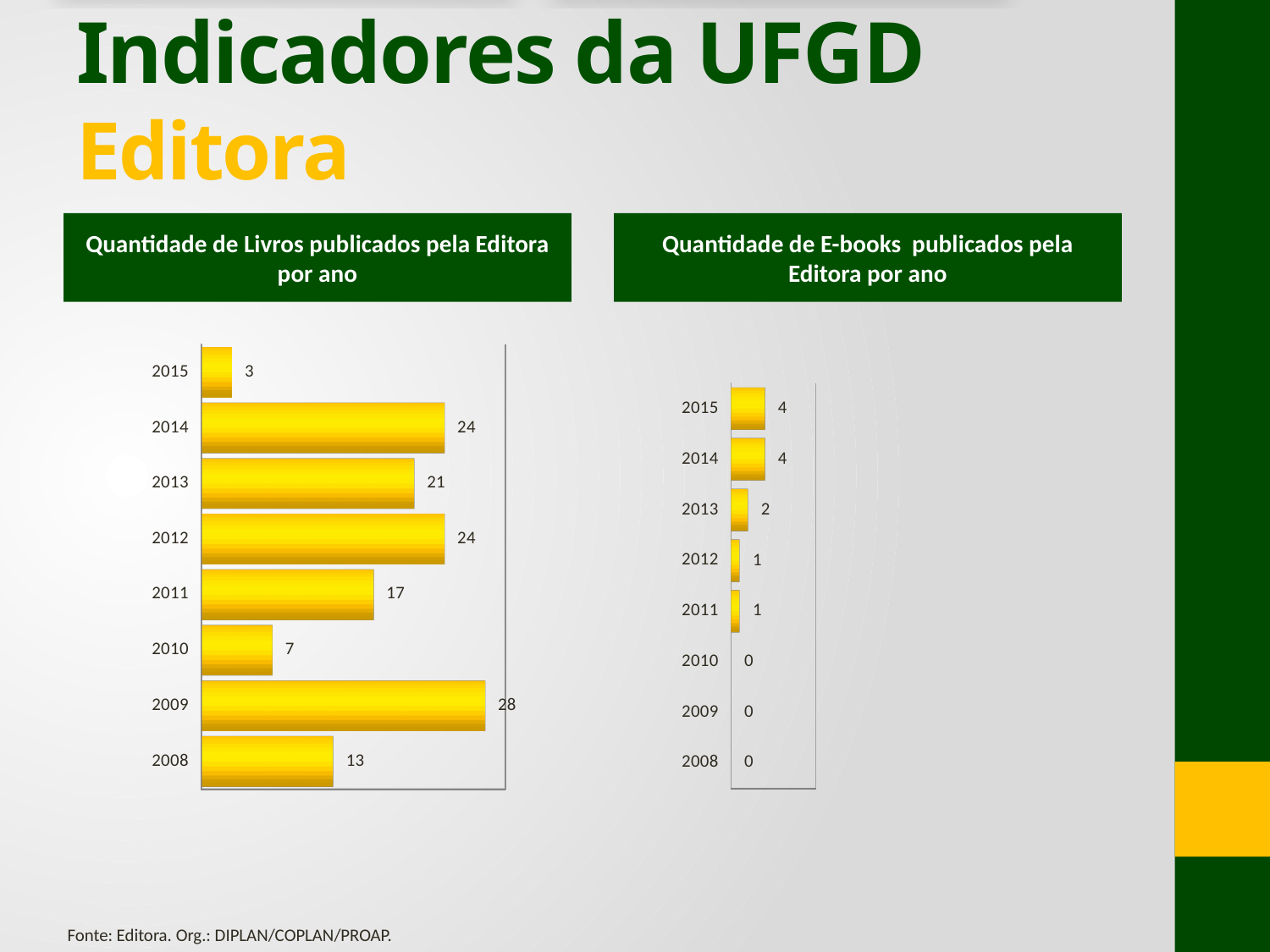
In the chart 'Quantidade de Livros publicados pela Editora por ano', how many years are shown? 8 In the chart 'Quantidade de Livros publicados pela Editora por ano', which year has the larger value, 2013 or 2010? 2013 What kind of chart is 'Quantidade de Livros publicados pela Editora por ano'? Bar chart In the chart 'Quantidade de E-books publicados pela Editora por ano', how many e-books were published in 2013? 2 In the chart 'Quantidade de Livros publicados pela Editora por ano', which year has the highest value? 2009 In the chart 'Quantidade de E-books publicados pela Editora por ano', what is the difference between the values for 2015 and 2012? 3 In the chart 'Quantidade de E-books publicados pela Editora por ano', what is the value for 2010? 0 In the chart 'Quantidade de E-books publicados pela Editora por ano', do the values generally rise or fall from 2008 to 2015? Rise In the chart 'Quantidade de E-books publicados pela Editora por ano', which year has the larger value, 2014 or 2011? 2014 In the chart 'Quantidade de Livros publicados pela Editora por ano', which year has the lowest value? 2015 In the chart 'Quantidade de Livros publicados pela Editora por ano', how many books were published in 2009? 28 In the chart 'Quantidade de Livros publicados pela Editora por ano', what is the difference between the values for 2014 and 2011? 7